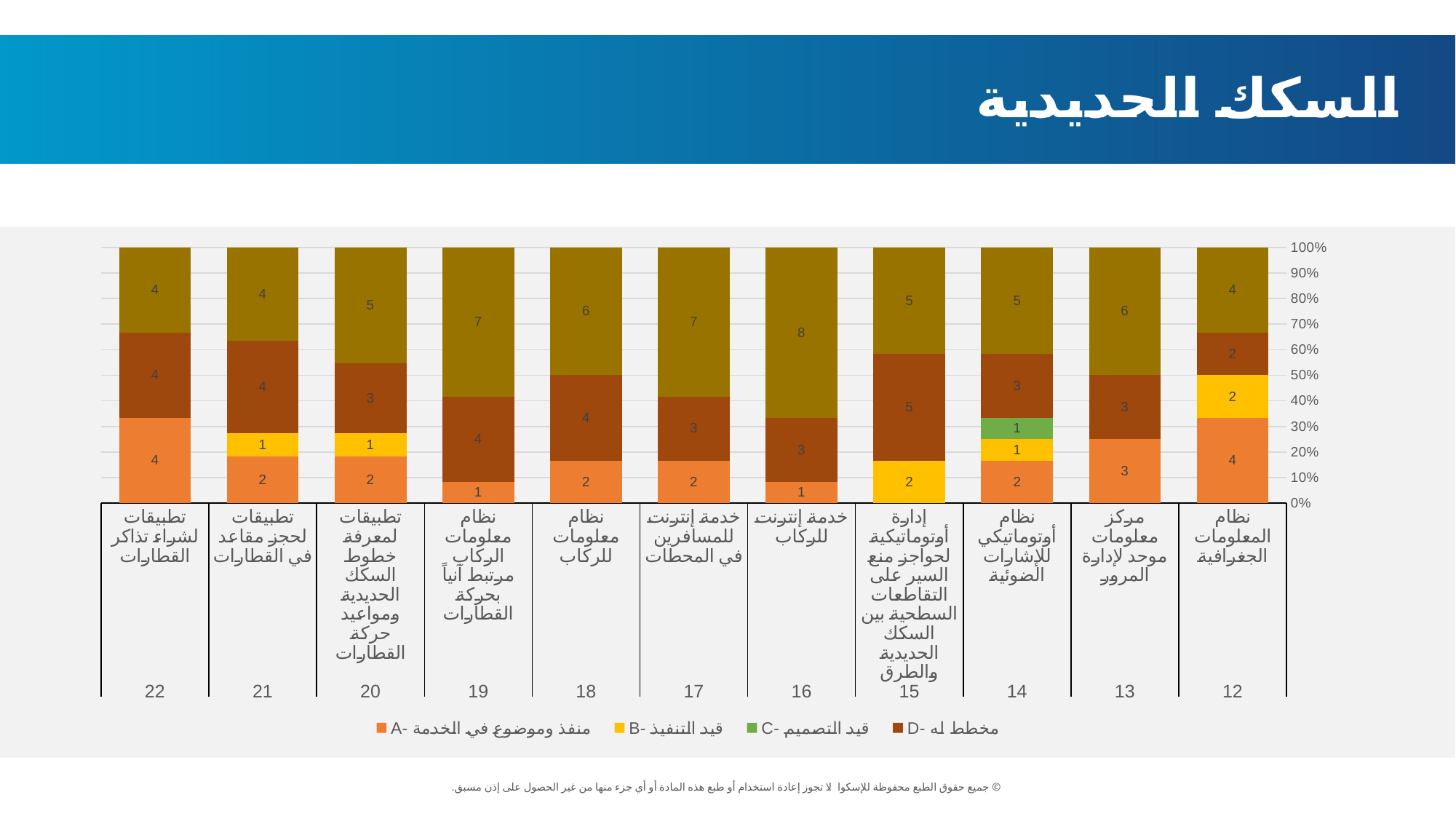
What is the value of the B- قيد التنفيذ segment for category 21 (تطبيقات لحجز مقاعد في القطارات)? 1 How many series does the legend list? 4 What is the value of the A- منفذ وموضوع في الخدمة segment for category 12 (نظام المعلومات الجغرافية)? 4 What kind of chart is shown on the slide? bar chart (100% stacked) How many categories (bars) are plotted in the chart? 11 What is the title of the slide? السكك الحديدية What is the value of the D- مخطط له segment for category 15 (إدارة أوتوماتيكية لحواجز منع السير)? 5 What is the total of all segments in the bar for category 14 (نظام أوتوماتيكي للإشارات الضوئية)? 12 Which is larger: the A- منفذ وموضوع في الخدمة value for category 22 or for category 13? category 22 What is the value of the C- قيد التصميم segment for category 14 (نظام أوتوماتيكي للإشارات الضوئية)? 1 Which category has the largest top (olive) segment? 16 (خدمة إنترنت للركاب) What is the difference between the D- مخطط له value for category 15 and the D- مخطط له value for category 12? 3